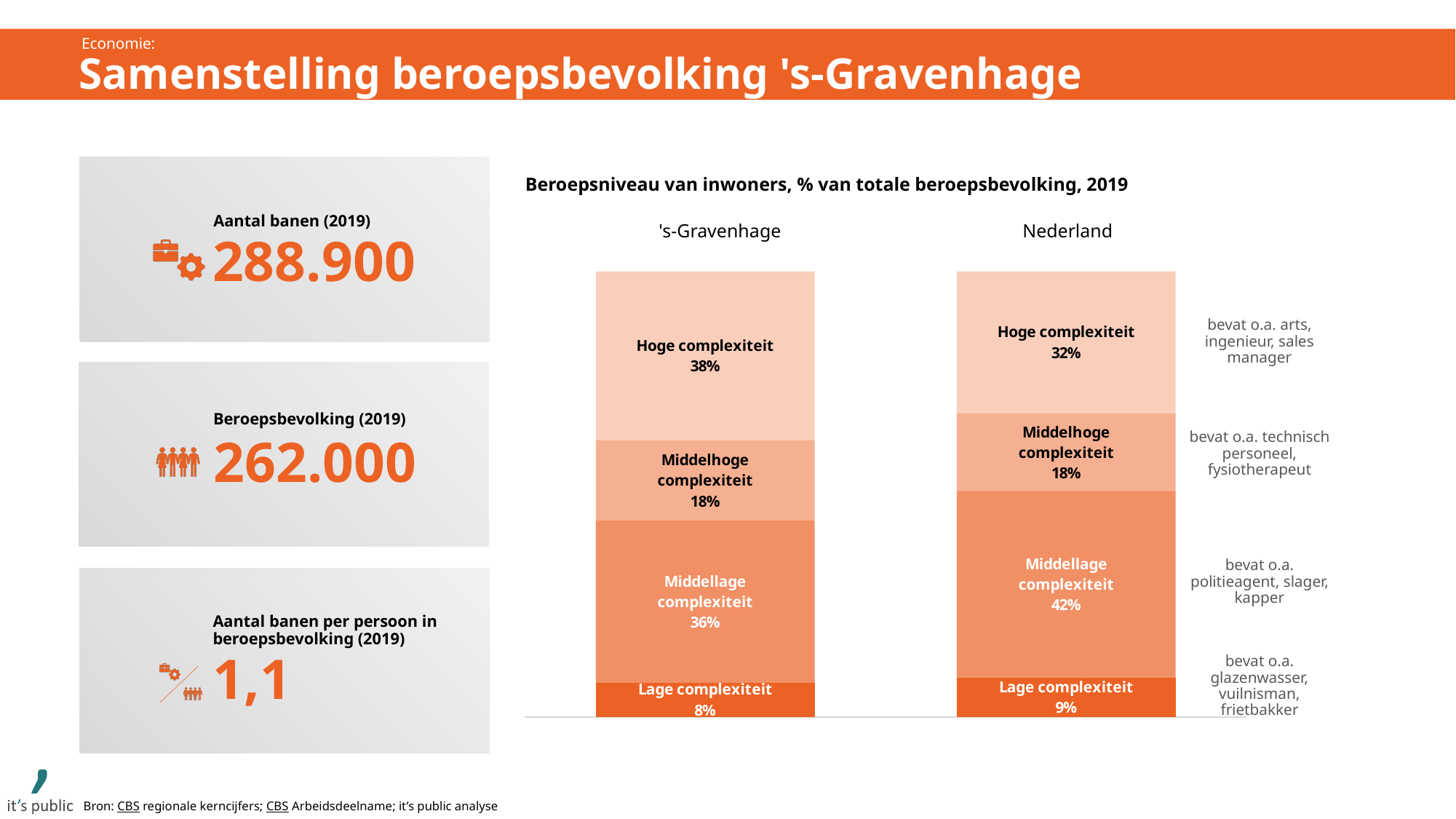
Which segment is the smallest in the 's-Gravenhage bar? Lage complexiteit What is the share of 'Hoge complexiteit' in the 's-Gravenhage bar? 38% What kind of chart is shown on the slide? Stacked bar chart Which segment is the largest in the Nederland bar? Middellage complexiteit How many percentage points higher is 'Hoge complexiteit' in 's-Gravenhage than in Nederland? 6 percentage points How many complexity levels (segments) does each bar contain? 4 What is the share of 'Lage complexiteit' in the 's-Gravenhage bar? 8% What is the share of 'Middellage complexiteit' in the Nederland bar? 42% How many bars does the chart show? 2 What is the share of 'Middelhoge complexiteit' in the Nederland bar? 18% Which has the larger share of 'Middellage complexiteit', 's-Gravenhage or Nederland? Nederland What is the title of the chart? Beroepsniveau van inwoners, % van totale beroepsbevolking, 2019